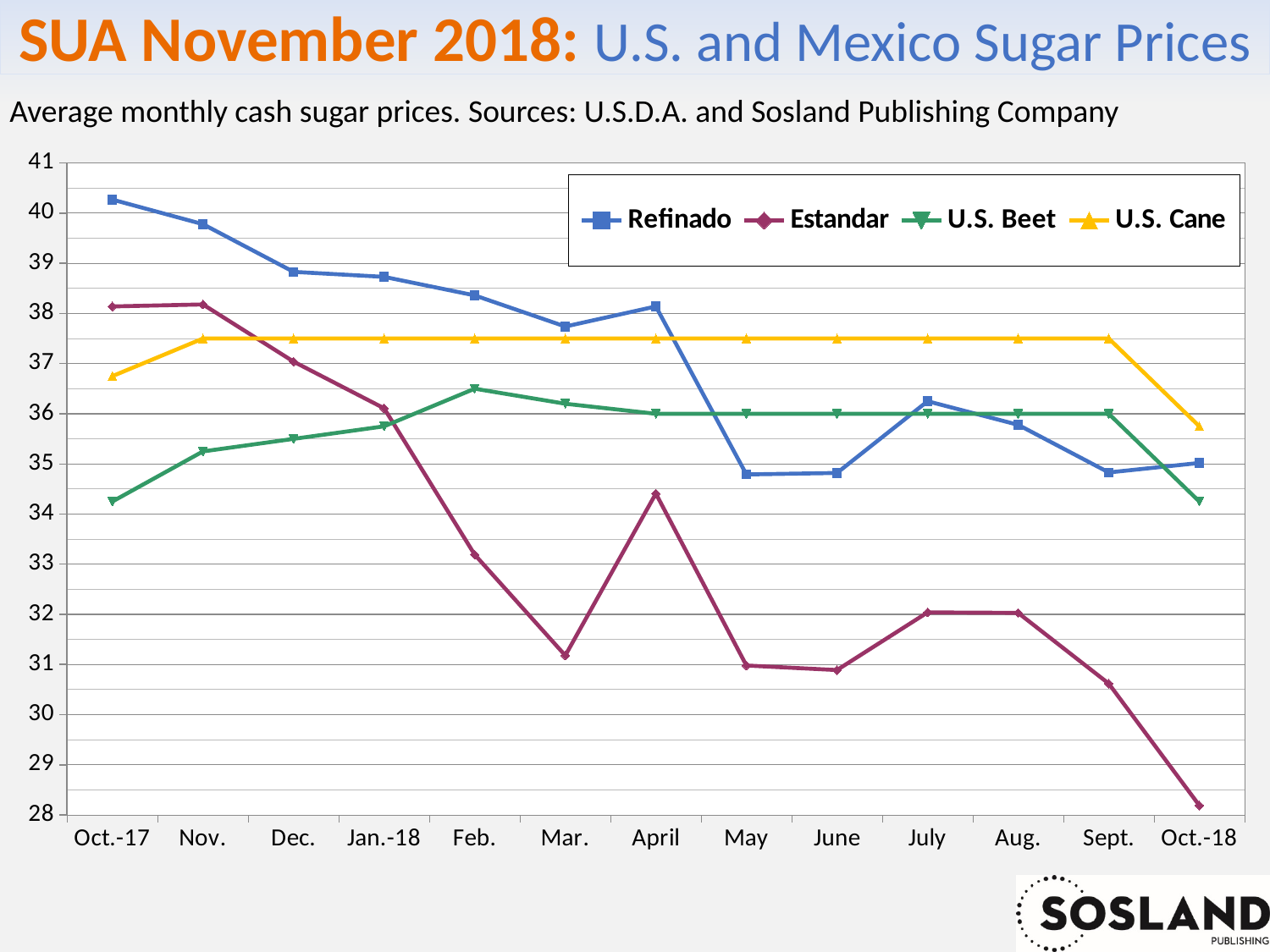
What is the value for U.S. Beet in June? 36 How many months are plotted along the x axis? 13 What kind of chart is shown on the slide? line chart Which series has the lowest value in Oct.-18? Estandar Which series has the highest value in Oct.-17? Refinado How many series does the legend list? 4 Is the value for U.S. Cane in Dec. greater or less than 37? greater Is the value for U.S. Beet in Oct.-17 greater or less than 35? less In May, which is larger: Refinado or U.S. Beet? U.S. Beet Does the Estandar series generally rise or fall from Oct.-17 to Oct.-18? fall Is the value for Refinado in Oct.-17 greater or less than 40? greater